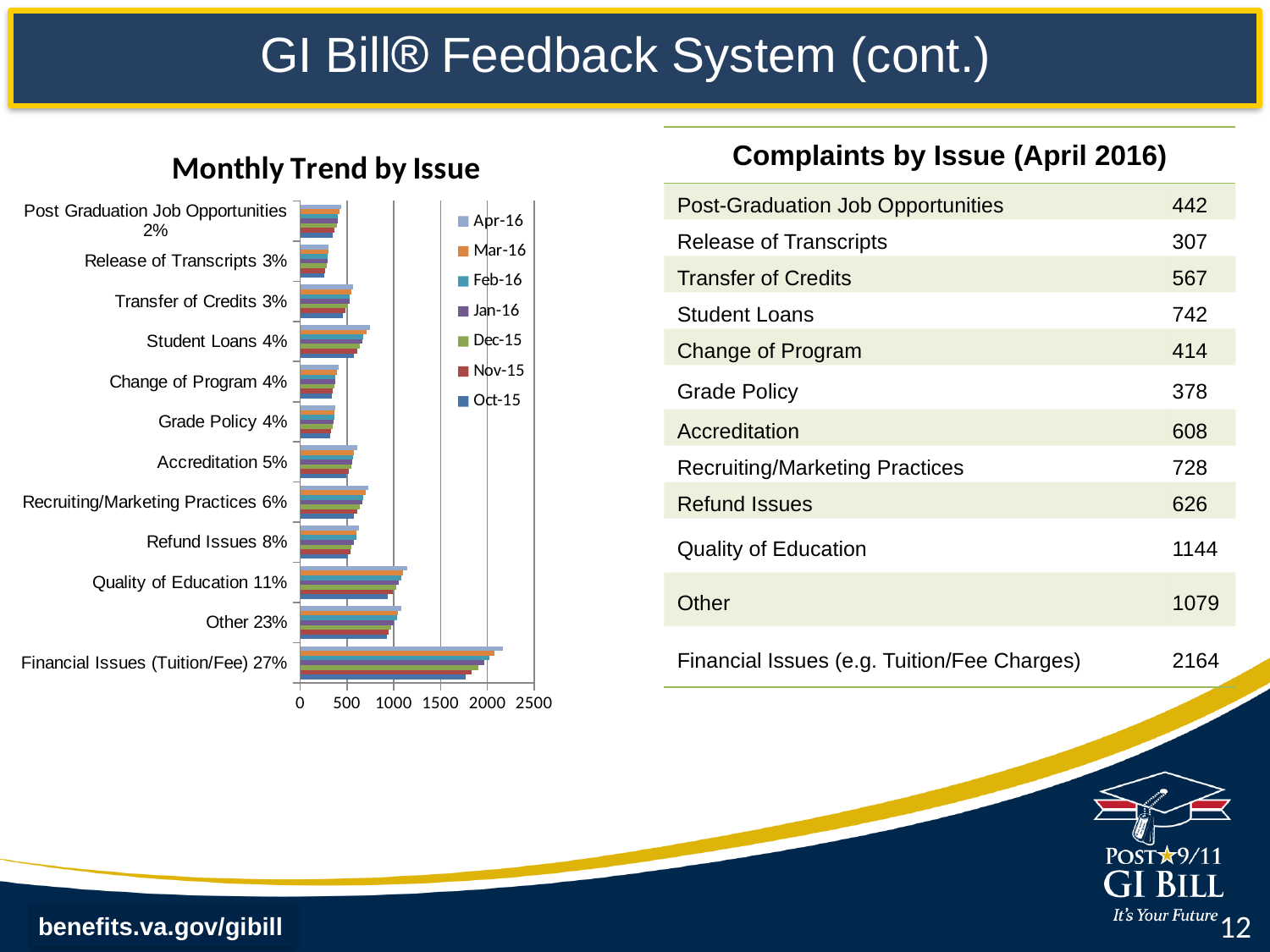
Which issue has the shortest bars in the "Monthly Trend by Issue" chart? Release of Transcripts In the "Monthly Trend by Issue" chart, is the Apr-16 value for Financial Issues (Tuition/Fee) greater or less than 2000? greater In the "Monthly Trend by Issue" chart, is the Apr-16 value for Quality of Education greater or less than 1000? greater Which month is listed first in the legend of the "Monthly Trend by Issue" chart? Apr-16 How many series does the legend of the "Monthly Trend by Issue" chart list? 7 Which issue has the longest bars in the "Monthly Trend by Issue" chart? Financial Issues (Tuition/Fee) What type of chart is "Monthly Trend by Issue"? bar chart How many issue categories are shown in the "Monthly Trend by Issue" chart? 12 In the "Monthly Trend by Issue" chart, which has the larger Apr-16 value: Quality of Education or Student Loans? Quality of Education In the "Monthly Trend by Issue" chart, is the Apr-16 value for Release of Transcripts greater or less than 500? less In the "Monthly Trend by Issue" chart, for Financial Issues (Tuition/Fee), is the Apr-16 bar longer or shorter than the Oct-15 bar? longer